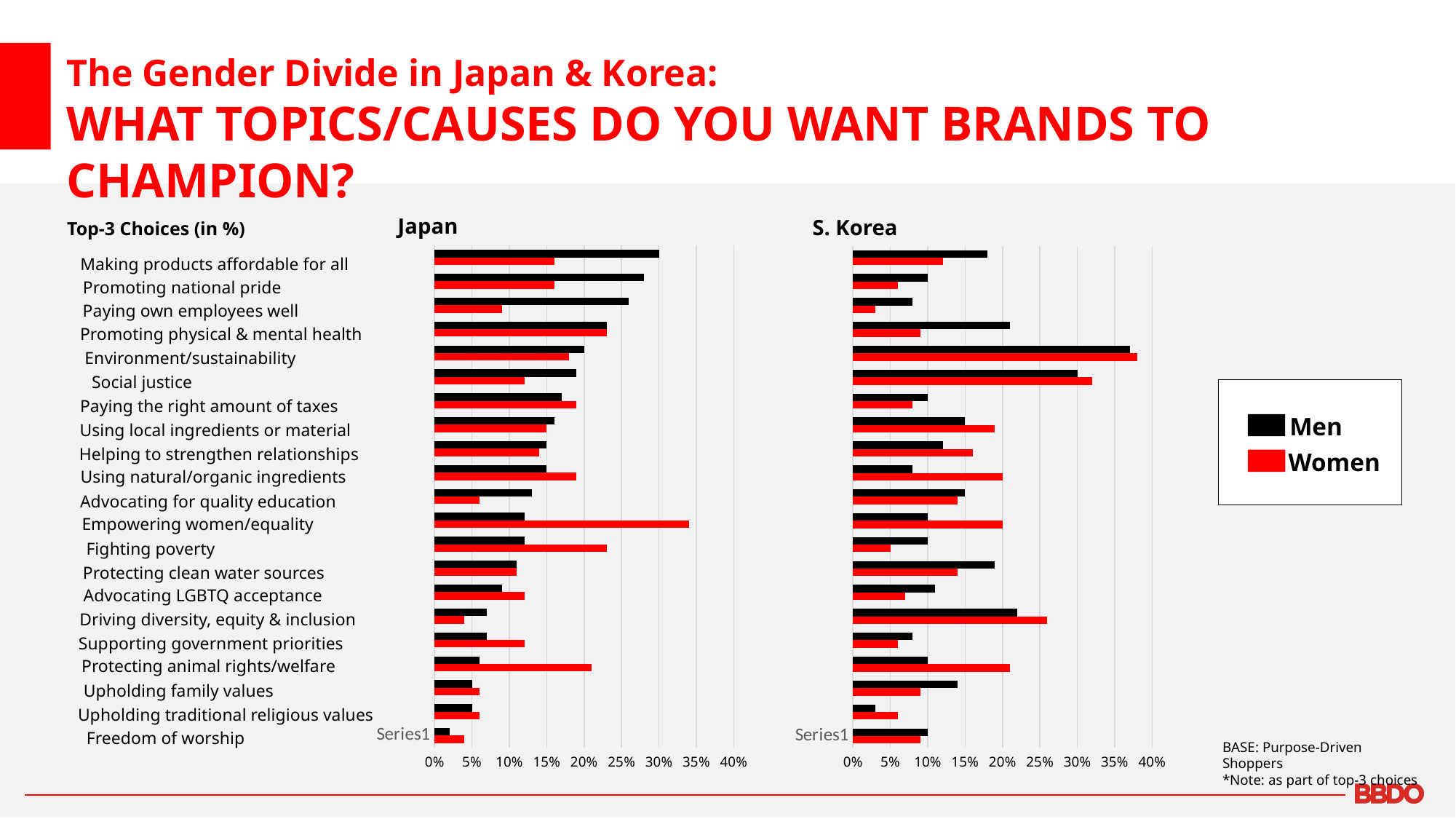
In the S. Korea chart, is the Men value for Environment/sustainability greater or less than 30%? greater How many topic categories are plotted in the S. Korea chart? 21 In the S. Korea chart, which category has the highest value for Women? Environment/sustainability In the Japan chart, is the Women value for Empowering women/equality greater or less than 30%? greater What kind of chart is the Japan chart? bar chart In the Japan chart, which category has the highest value for Women? Empowering women/equality How many series does the legend list? 2 In the S. Korea chart, which category has the highest value for Men? Environment/sustainability In the Japan chart, is the Men value for Paying own employees well greater or less than 20%? greater In the Japan chart, which category has the lowest value for Men? Freedom of worship In the Japan chart, for Protecting animal rights/welfare, which is larger: the Men value or the Women value? Women In the S. Korea chart, for Promoting physical & mental health, which is larger: the Men value or the Women value? Men